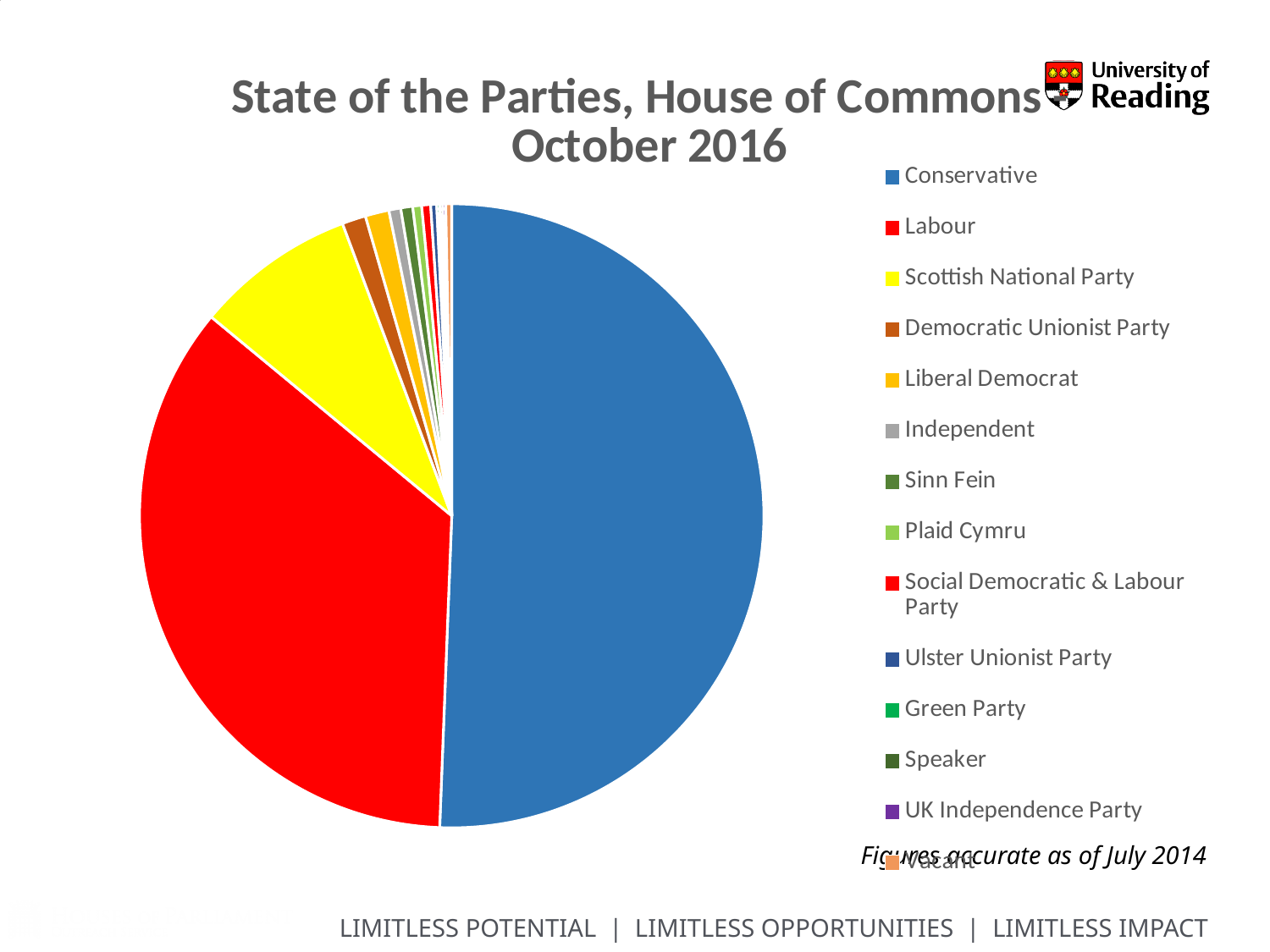
What is the title of the chart? State of the Parties, House of Commons October 2016 Which slice is larger, Conservative or Labour? Conservative What colour is the Scottish National Party slice? yellow How many parties or categories does the legend list? 14 Which party has the largest slice of the pie? Conservative Which slice is larger, Scottish National Party or Liberal Democrat? Scottish National Party Which slice is larger, Scottish National Party or Democratic Unionist Party? Scottish National Party What kind of chart is shown on the slide? pie chart